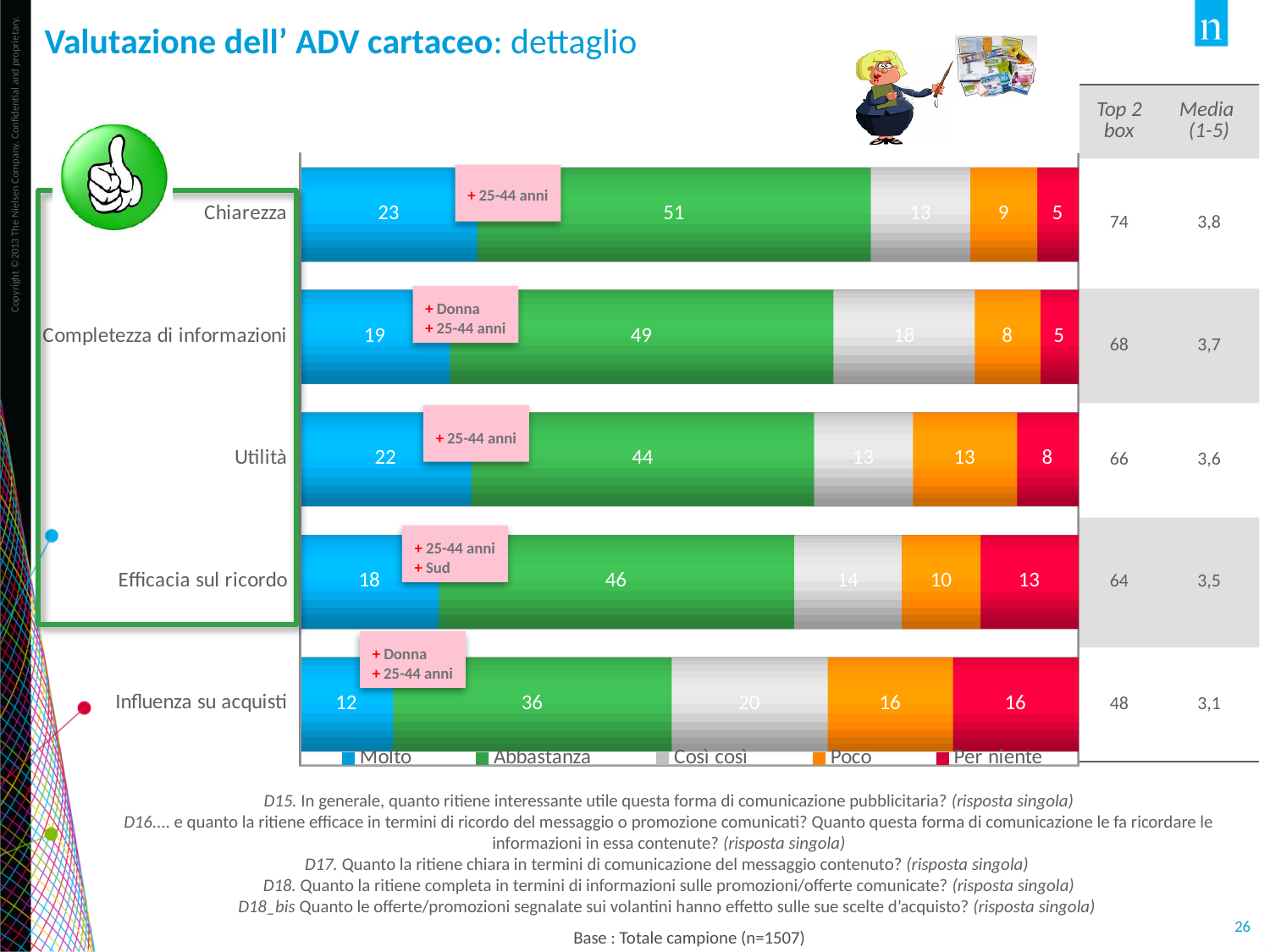
How many categories are plotted in the chart? 5 Which category has the lowest 'Molto' value? Influenza su acquisti What kind of chart is shown on the slide? Stacked bar chart Which is larger: the 'Così così' value for Influenza su acquisti or for Efficacia sul ricordo? Influenza su acquisti What is the 'Molto' value for Chiarezza? 23 What is the difference between the 'Molto' values for Chiarezza and Influenza su acquisti? 11 What is the 'Abbastanza' value for Completezza di informazioni? 49 What is the 'Poco' value for Utilità? 13 How many series does the chart legend list? 5 Which legend entry is shown in red? Per niente Which category has the highest 'Abbastanza' value? Chiarezza What is the 'Per niente' value for Influenza su acquisti? 16